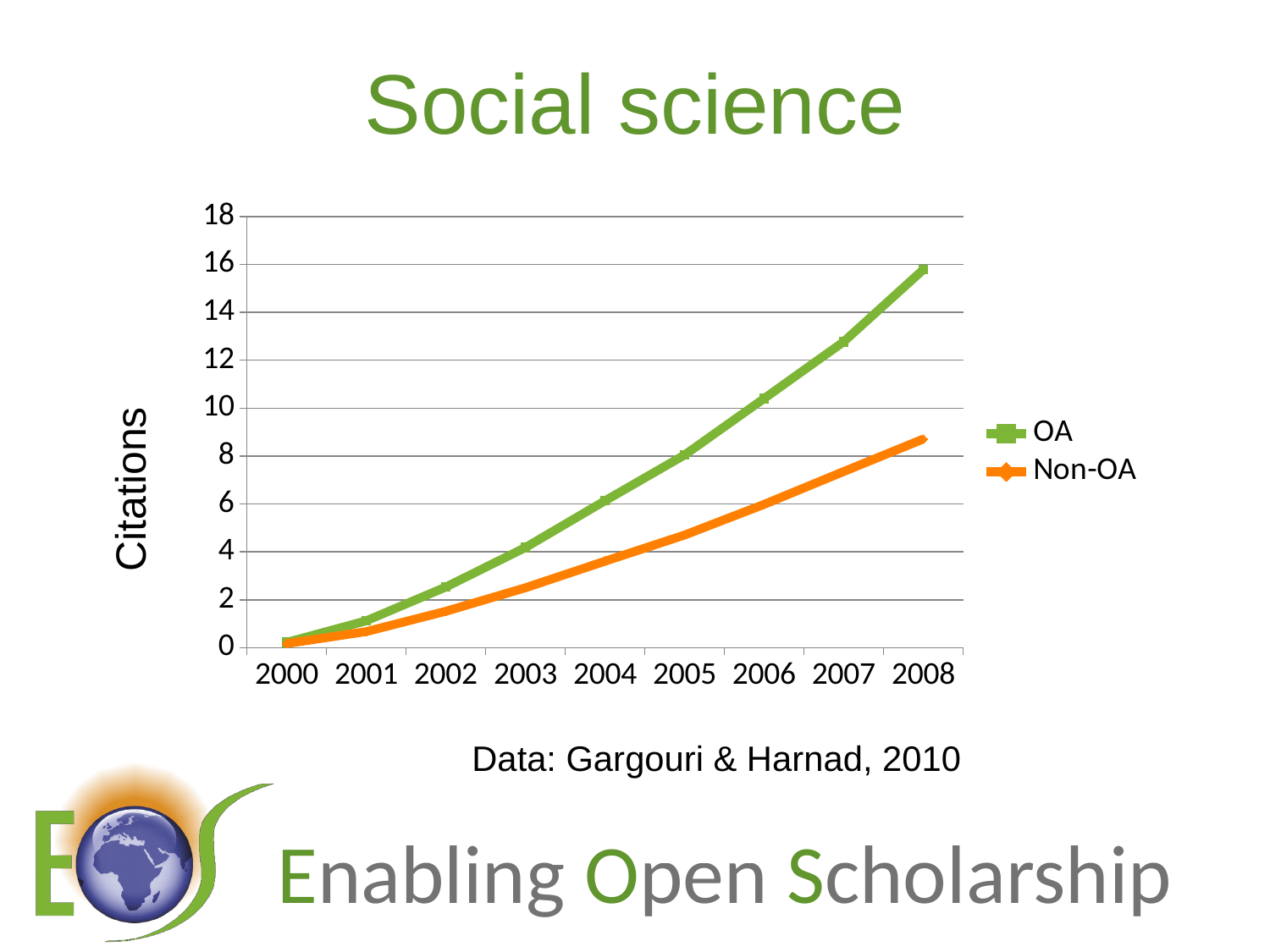
What type of chart is shown on the slide? line chart Is the value for OA in 2007 greater or less than 12? greater How many years are shown on the x axis? 9 In which year is the Non-OA series at its lowest value? 2000 Do the OA citations rise or fall from 2000 to 2008? rise Which series has the higher value in 2008, OA or Non-OA? OA Is the value for Non-OA in 2008 greater or less than 10? less Is the value for Non-OA in 2005 greater or less than 6? less How many series does the legend list? 2 What is the label on the y axis? Citations In which year does the OA series reach its highest value? 2008